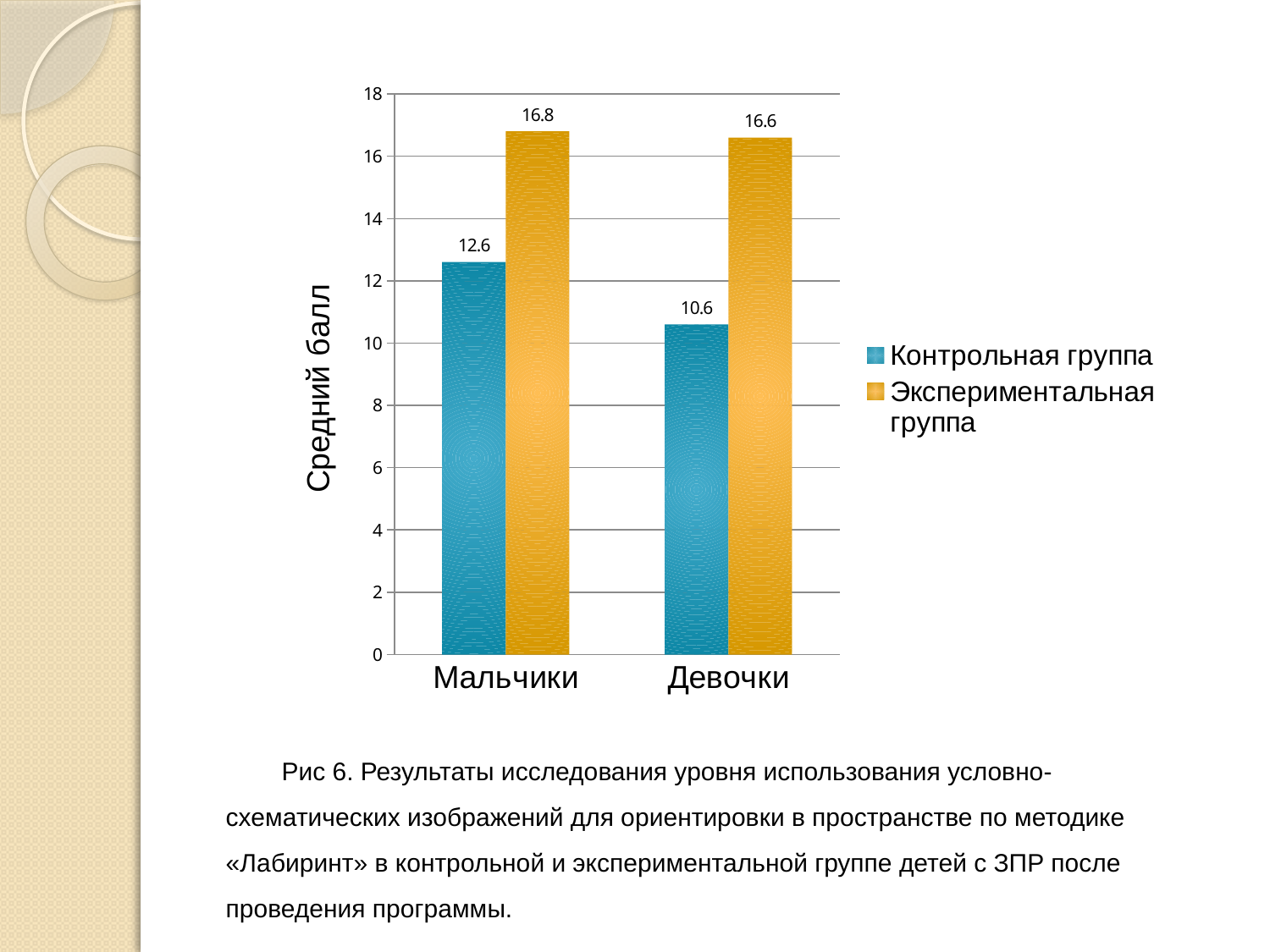
What is the value for Контрольная группа for Девочки? 10.6 What is the label of the vertical axis? Средний балл How many categories are shown on the x axis? 2 How many series does the legend list? 2 Which category has the lowest value for Контрольная группа? Девочки What kind of chart is shown on the slide? Bar chart What is the value for Экспериментальная группа for Мальчики? 16.8 What is the value for Экспериментальная группа for Девочки? 16.6 What is the difference between the Экспериментальная группа and Контрольная группа values for Девочки? 6 Which is larger for Мальчики: Контрольная группа or Экспериментальная группа? Экспериментальная группа What is the difference between the Экспериментальная группа and Контрольная группа values for Мальчики? 4.2 What is the value for Контрольная группа for Мальчики? 12.6